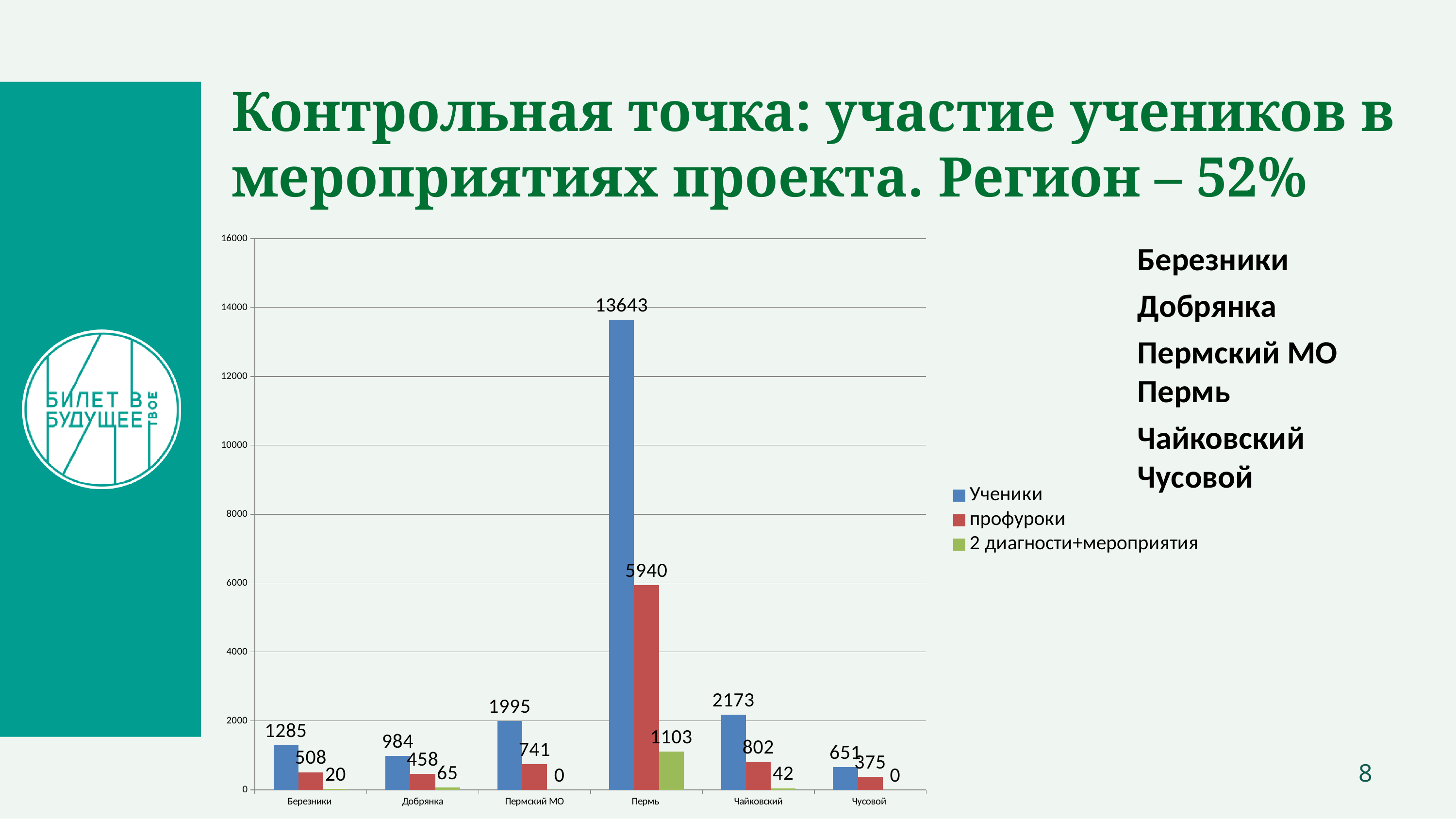
How many categories are shown on the x axis? 6 Which category has the highest value for Ученики? Пермь What is the difference between Ученики and профуроки for Пермь? 7703 What is the value of 2 диагности+мероприятия for Добрянка? 65 How many series does the legend list? 3 Which is larger: Ученики for Чайковский or Ученики for Пермский МО? Чайковский What is the value of Ученики for Пермь? 13643 Is the value of Ученики for Пермь greater or less than 12000? greater What is the value of профуроки for Чайковский? 802 What type of chart is shown on the slide? bar chart Which series is shown in red in the legend? профуроки Which category has the lowest value for Ученики? Чусовой